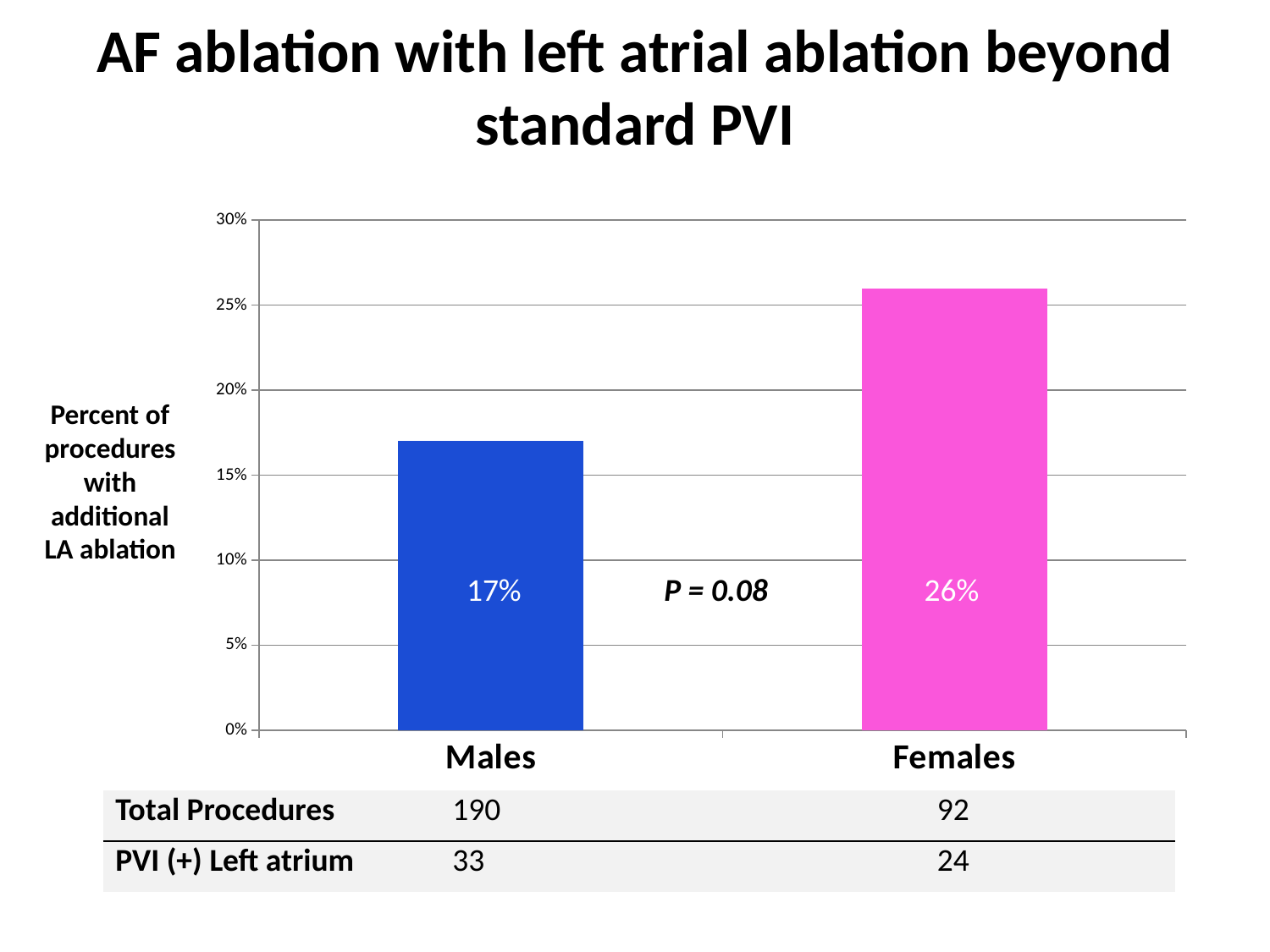
Which category has the lowest value? Males What is the value for Males? 17% Is the value for Males greater or less than 20%? less Which category has the highest value? Females What kind of chart is shown on the slide? bar chart What P value is printed between the two bars? P = 0.08 Which is larger, the value for Males or the value for Females? Females Is the value for Females greater or less than 25%? greater How many categories are shown on the x axis? 2 What is the difference between the values for Females and Males? 9% What is the value for Females? 26% What is the title of the chart? AF ablation with left atrial ablation beyond standard PVI